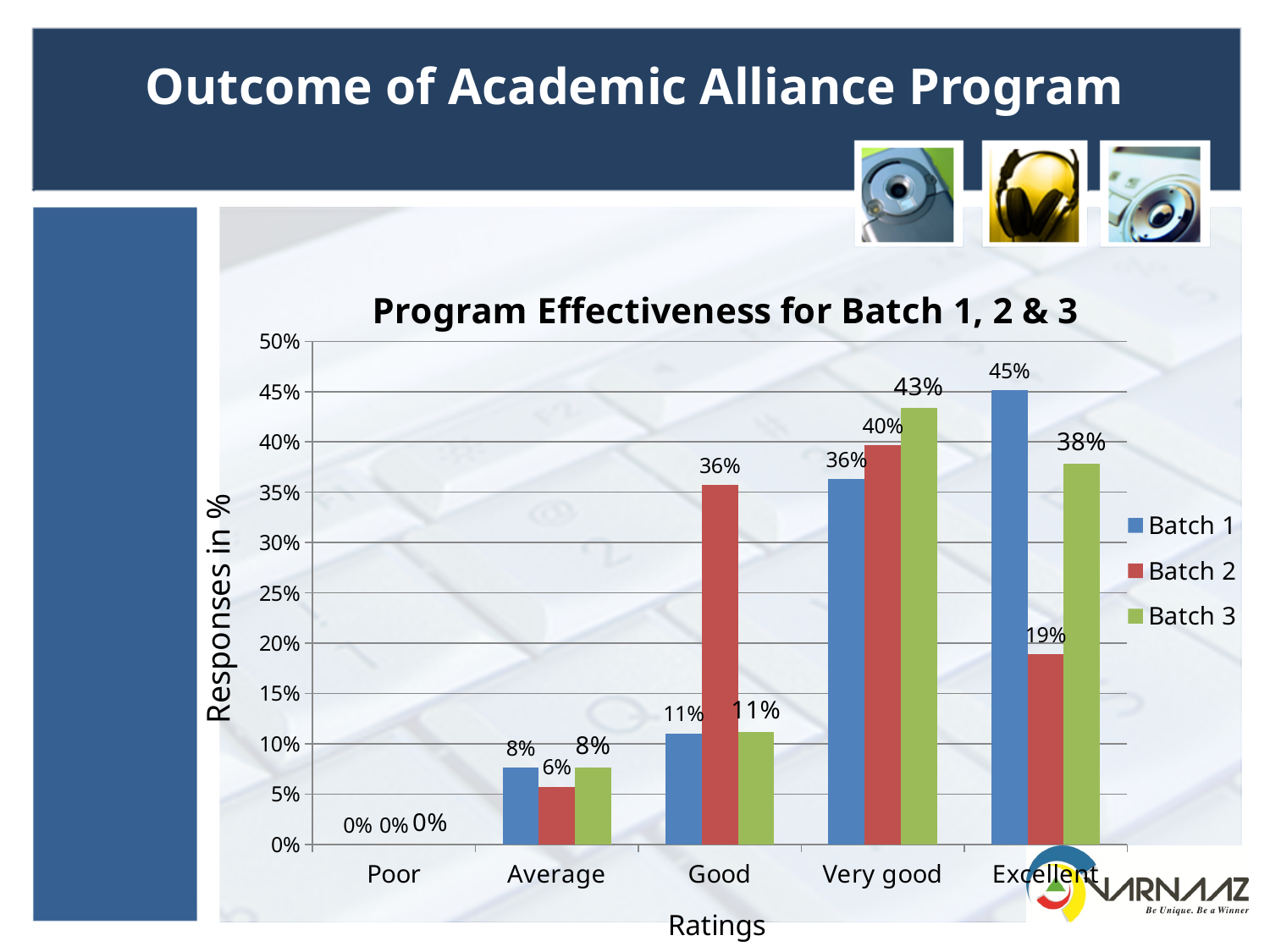
Which category has the lowest value for Batch 3? Poor What is the value for Batch 1 in the Excellent category? 45% Is the value for Batch 2 in the Excellent category greater or less than 20%? less What is the value for Batch 3 in the Very good category? 43% What is the value for Batch 2 in the Average category? 6% Which is larger in the Very good category, Batch 1 or Batch 3? Batch 3 Which category has the highest value for Batch 2? Very good How many rating categories are shown on the x axis? 5 How many series does the legend list? 3 What is the difference between Batch 1 and Batch 2 in the Excellent category? 26% What is the value for Batch 2 in the Good category? 36% What type of chart is shown on the slide? Bar chart